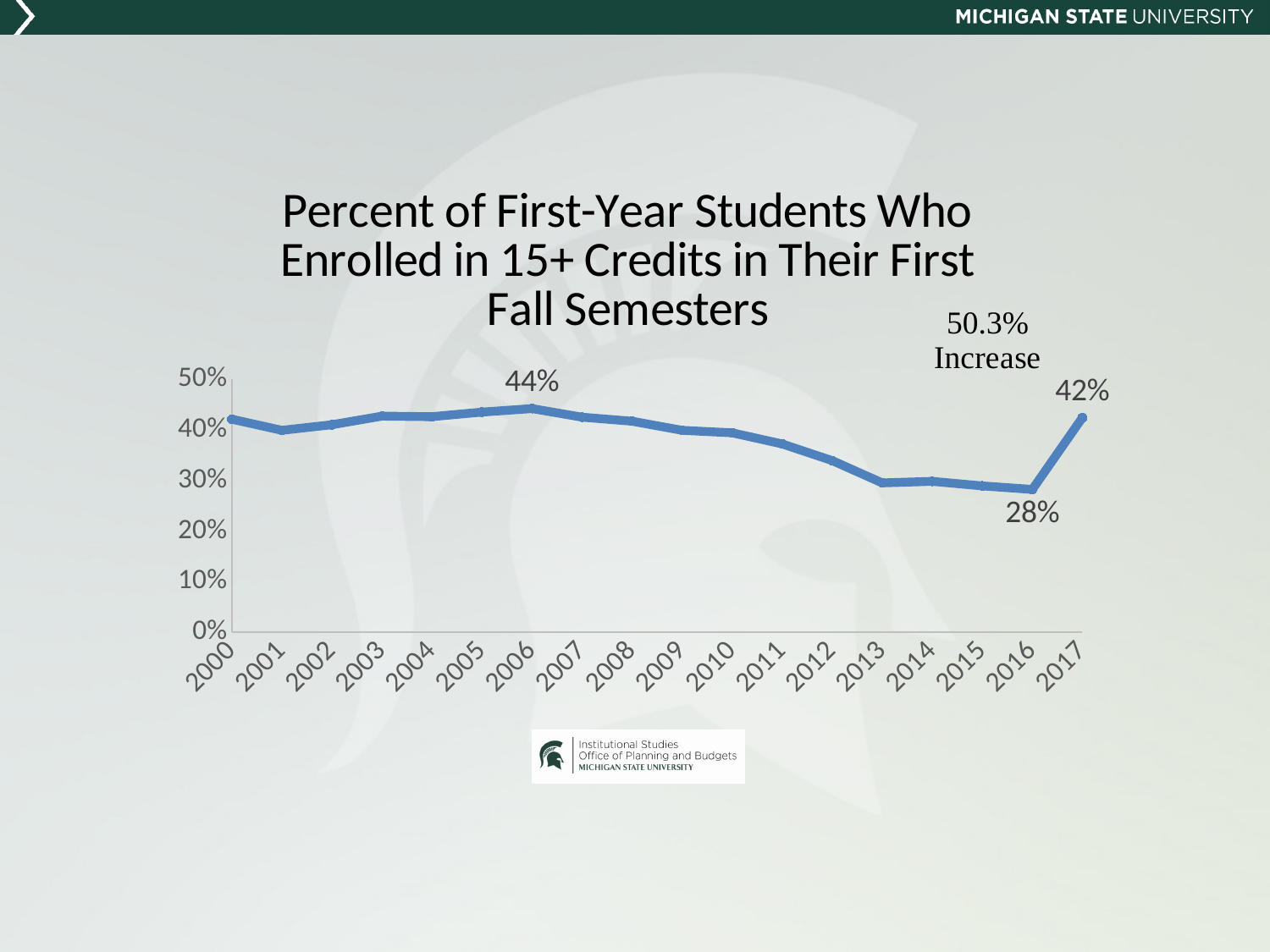
What is the value for 2006? 44% How many years are plotted on the x axis? 18 What is the value for 2016? 28% Which year has the highest value? 2006 Which year has the lowest value? 2016 What is the value for 2017? 42% Is the value for 2011 greater or less than 30%? greater What kind of chart is shown? line chart Is the value for 2012 greater or less than 40%? less Which is larger, the value for 2006 or the value for 2017? 2006 Do the values rise or fall from 2006 to 2016? fall What is the difference between the values for 2017 and 2016? 14 percentage points